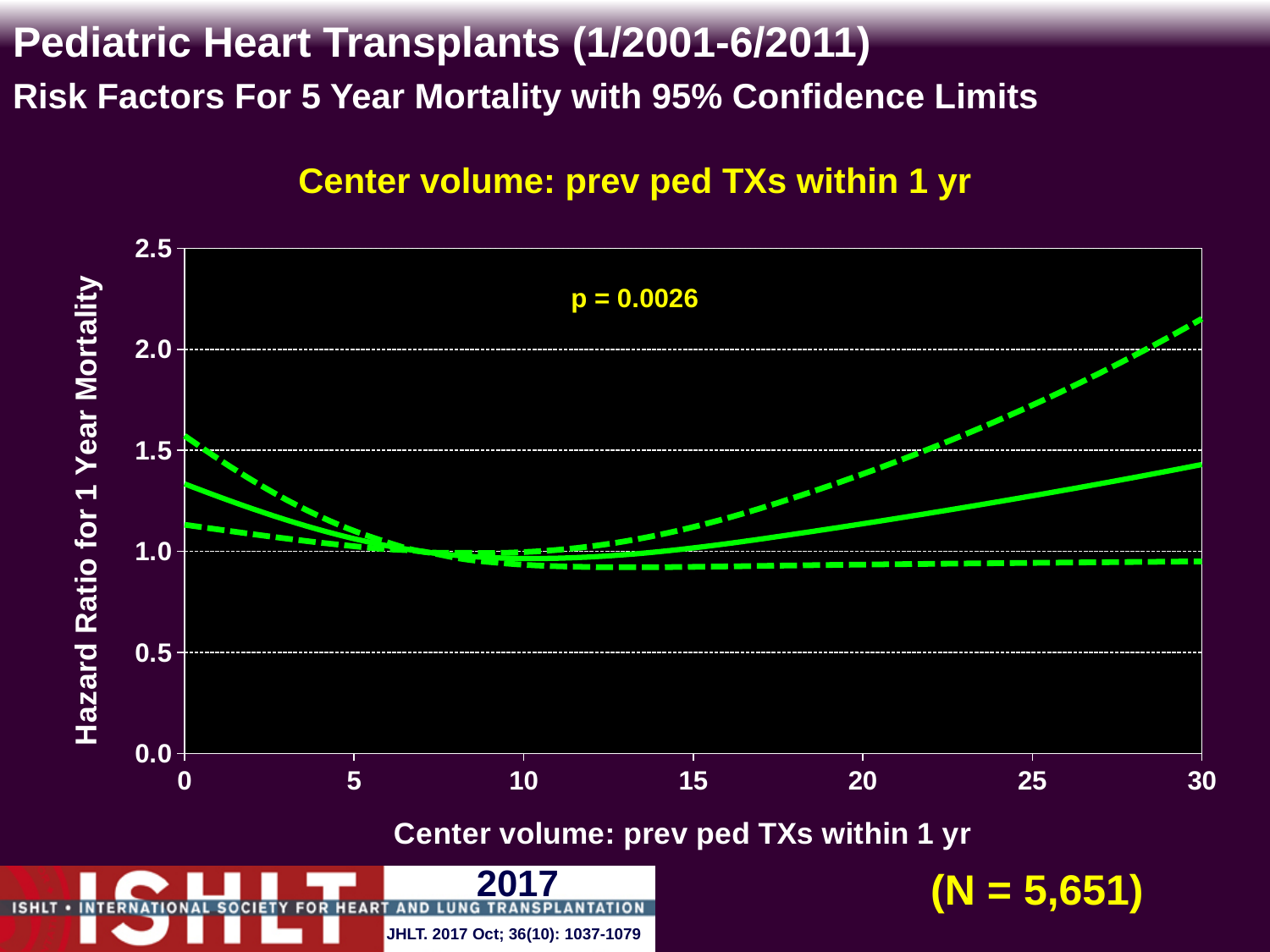
Is the value of the upper dashed confidence limit at a center volume of 30 greater or less than 2.0? greater At a center volume of 30, which is larger: the upper dashed confidence limit or the lower dashed confidence limit? upper dashed confidence limit What is the label of the y axis? Hazard Ratio for 1 Year Mortality Does the solid hazard ratio line rise or fall as center volume increases from 0 to 10? fall What kind of chart is shown on the slide? line chart How many lines are plotted on the chart? 3 Is the value of the upper dashed confidence limit at a center volume of 20 greater or less than 1.5? less Is the value of the lower dashed confidence limit at a center volume of 30 greater or less than 1.0? less What p-value is printed on the chart? p = 0.0026 Does the solid hazard ratio line rise or fall as center volume increases from 15 to 30? rise